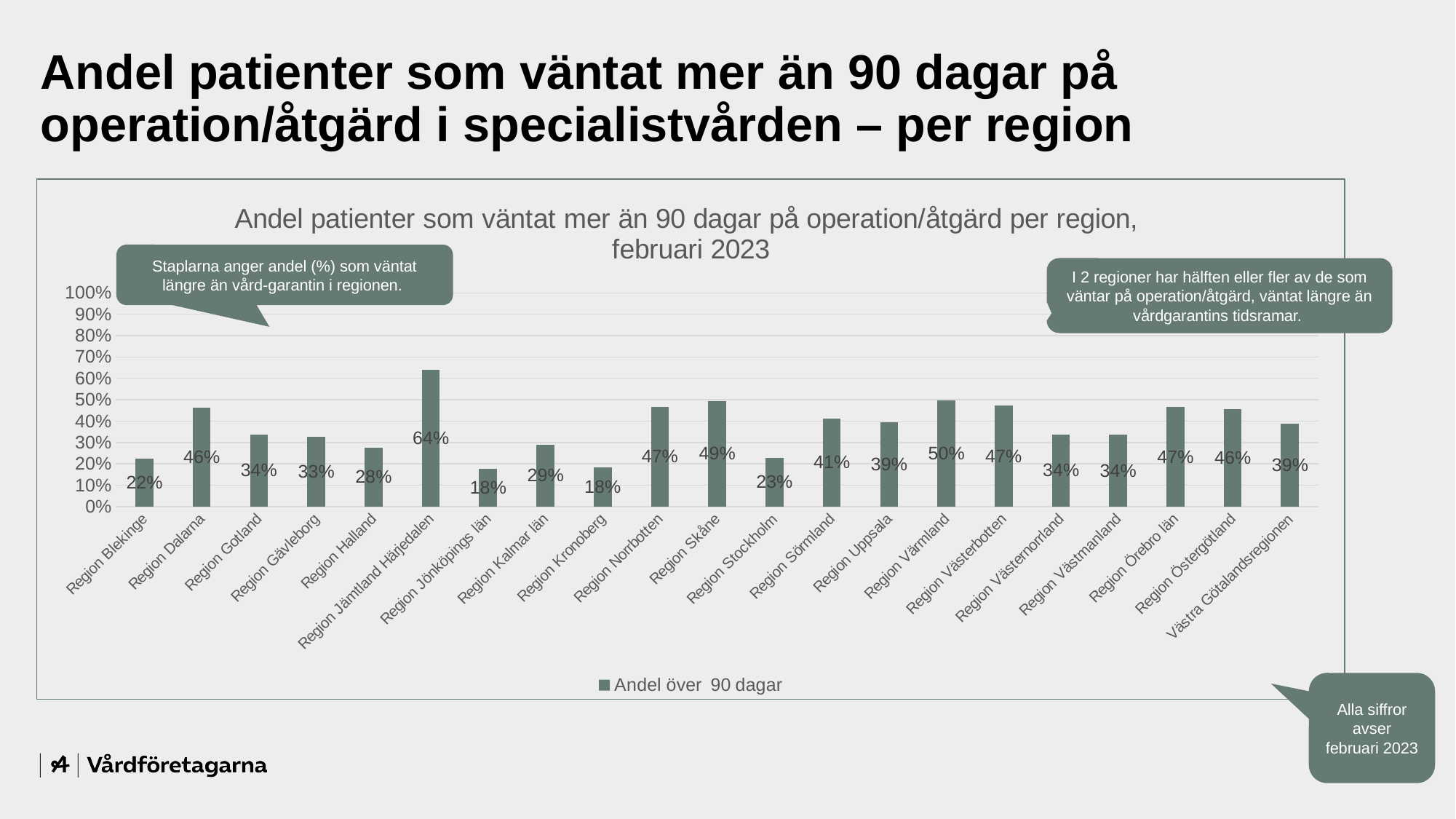
What is the difference between the values for Region Jämtland Härjedalen and Region Blekinge? 42 percentage points What is the value for Region Stockholm? 23% What is the value for Region Värmland? 50% What is the value for Region Jämtland Härjedalen? 64% Is the value for Region Jämtland Härjedalen greater or less than 60%? greater How many series does the legend list? 1 Which is larger, the value for Region Dalarna or the value for Region Halland? Region Dalarna What is the value for Västra Götalandsregionen? 39% What kind of chart is shown? Bar chart How many regions are shown on the x axis? 21 Which region has the highest value? Region Jämtland Härjedalen What is the difference between the values for Region Skåne and Region Stockholm? 26 percentage points